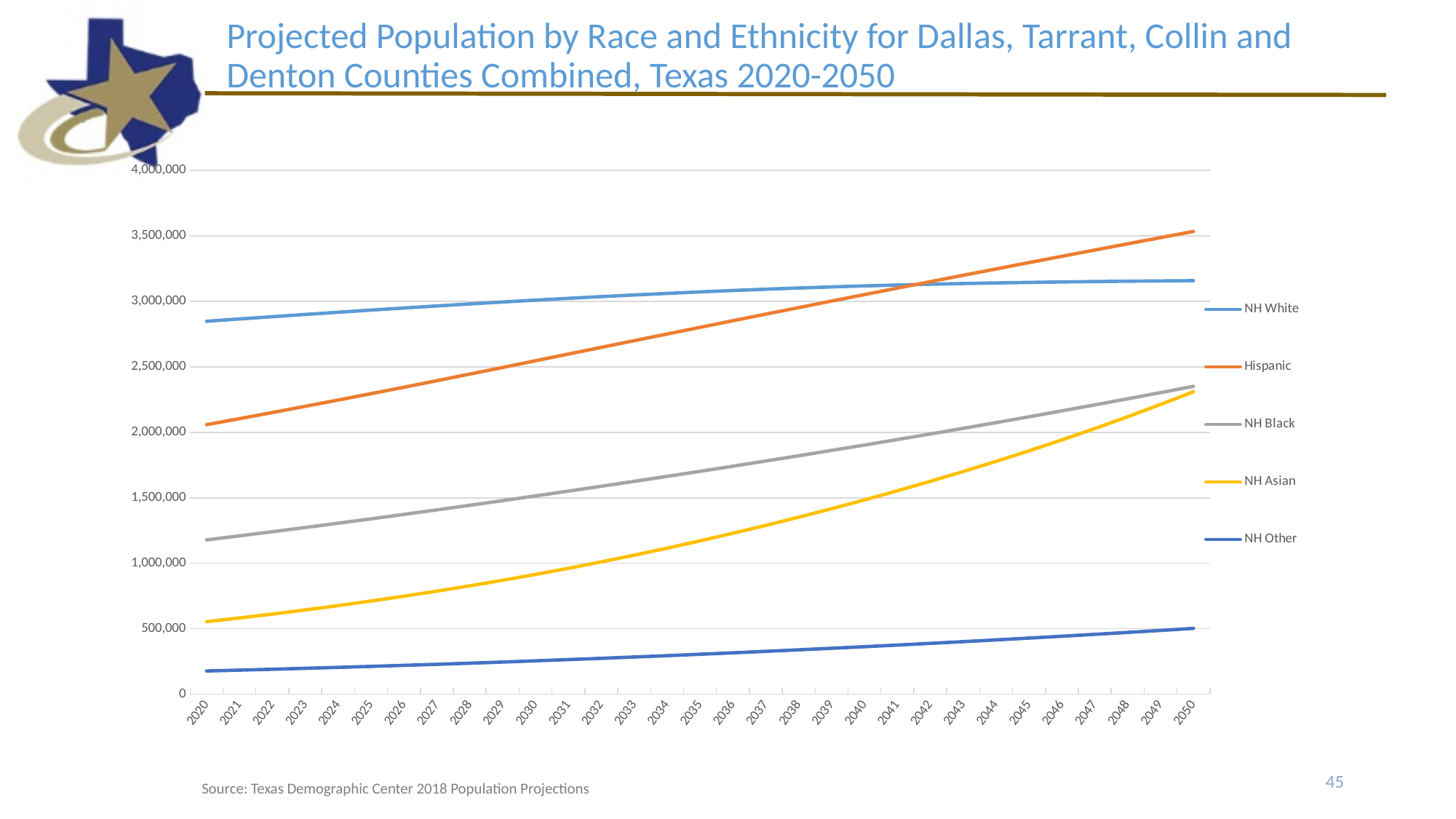
Which group has the lowest projected population across the whole period? NH Other Is the NH White value for 2020 greater or less than 3,000,000? less In 2020, which is larger: the NH Black population or the NH Asian population? NH Black Does the Hispanic line rise or fall from 2020 to 2050? rise In 2050, which is larger: the Hispanic population or the NH White population? Hispanic How many series does the legend list? 5 What is the source cited below the chart? Texas Demographic Center 2018 Population Projections Is the NH Black value for 2050 greater or less than 2,000,000? greater How many years are shown along the x axis? 31 Which group has the highest projected population in 2050? Hispanic Which group has the highest projected population in 2020? NH White What kind of chart is shown on the slide? Line chart